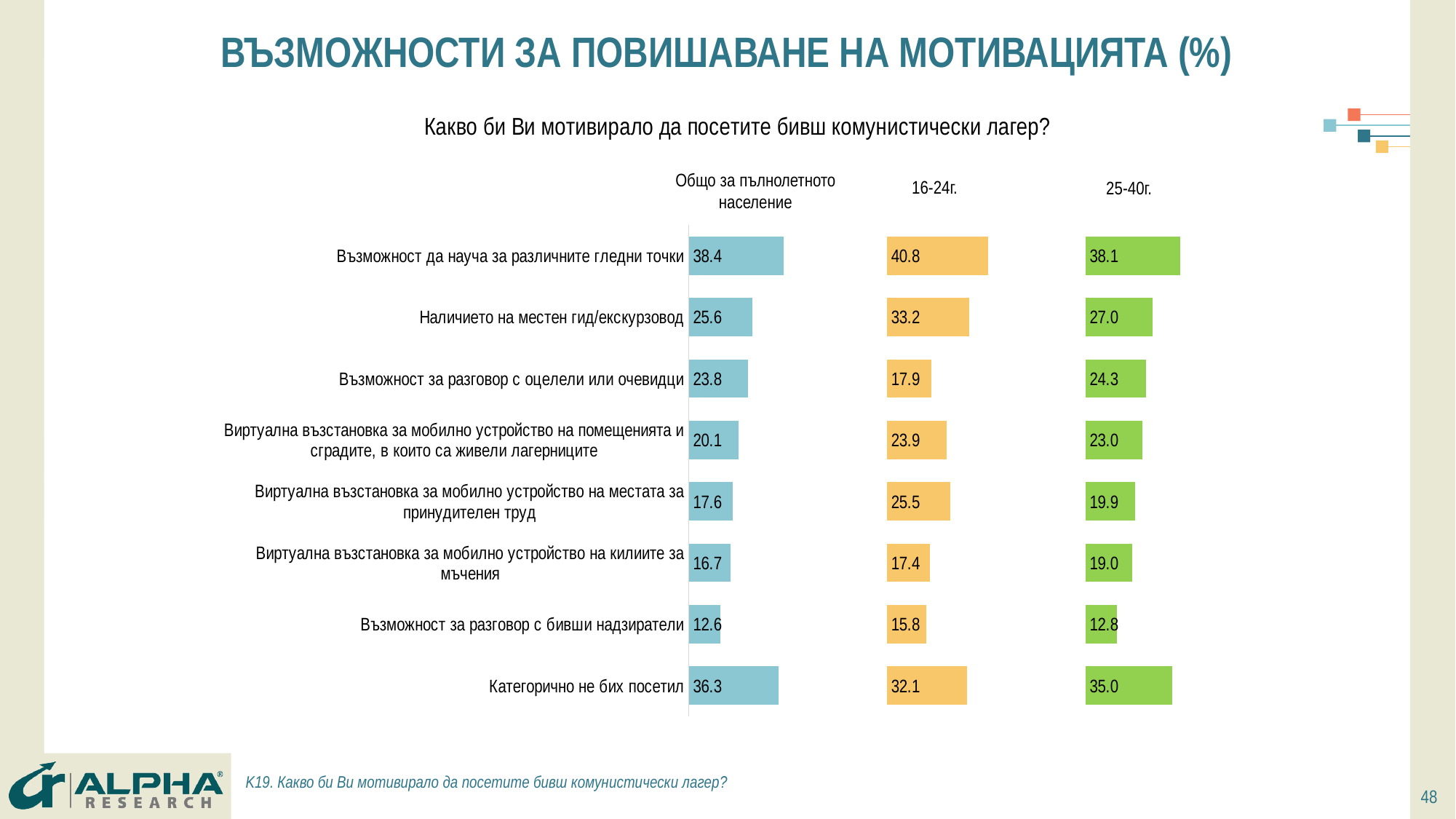
In the "25-40г." chart, what is the value for "Категорично не бих посетил"? 35.0 In the "Общо за пълнолетното население" chart, which category has the lowest value? Възможност за разговор с бивши надзиратели In the "Общо за пълнолетното население" chart, what is the difference between "Наличието на местен гид/екскурзовод" and "Възможност за разговор с оцелели или очевидци"? 1.8 In the "16-24г." chart, what is the value for "Възможност за разговор с бивши надзиратели"? 15.8 In the "25-40г." chart, what is the difference between "Възможност да науча за различните гледни точки" and "Категорично не бих посетил"? 3.1 In the "16-24г." chart, what is the value for "Наличието на местен гид/екскурзовод"? 33.2 What kind of chart is used on this slide? Bar chart In the "16-24г." chart, which category has the highest value? Възможност да науча за различните гледни точки How many categories are shown in the "Общо за пълнолетното население" chart? 8 In the "16-24г." chart, which is larger: "Възможност за разговор с оцелели или очевидци" or "Виртуална възстановка за мобилно устройство на местата за принудителен труд"? Виртуална възстановка за мобилно устройство на местата за принудителен труд What colour are the bars in the "25-40г." chart? Green In the "Общо за пълнолетното население" chart, what is the value for "Възможност да науча за различните гледни точки"? 38.4